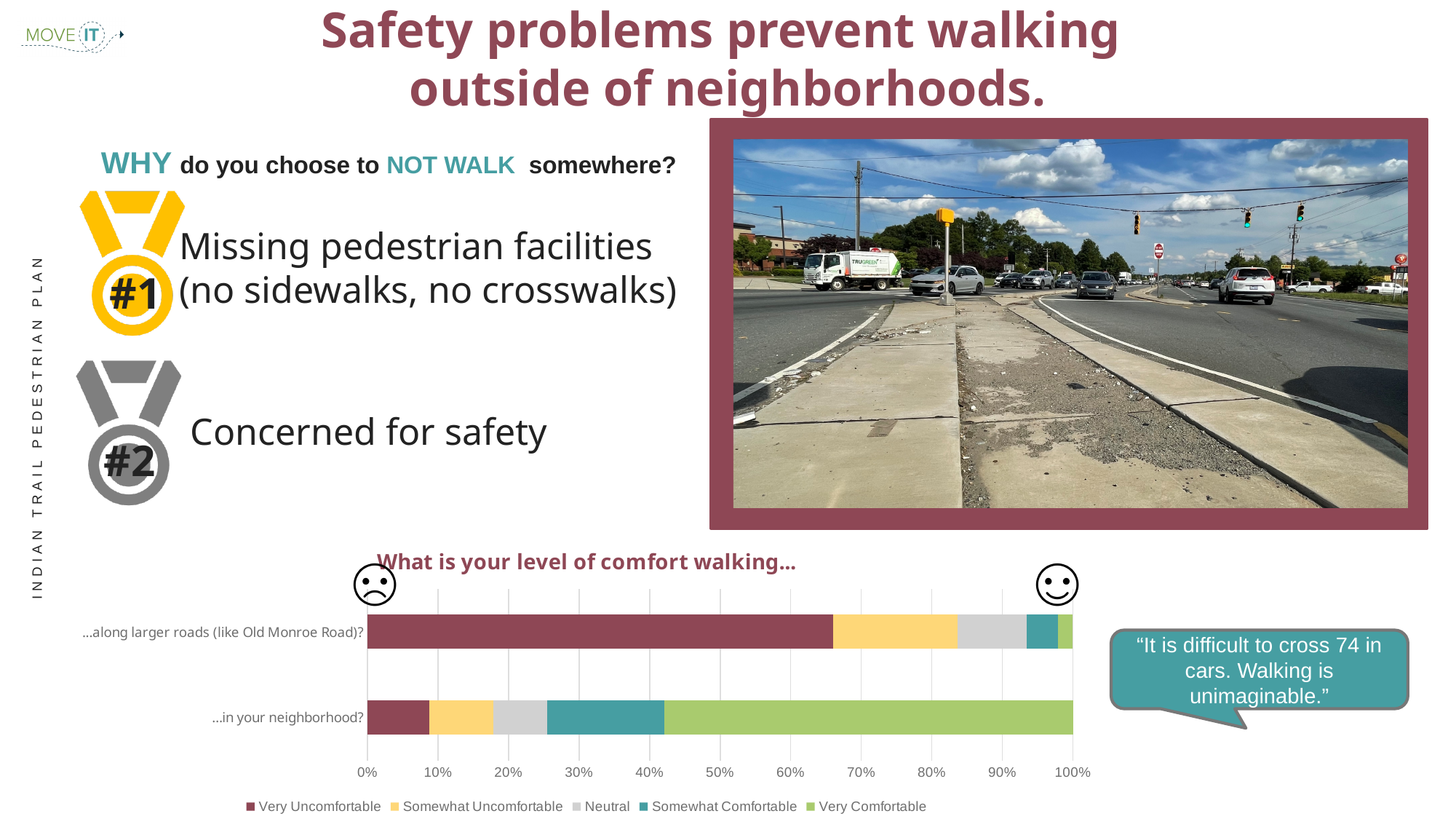
Is the 'Very Uncomfortable' share for '…in your neighborhood?' greater or less than 20%? less How many categories (rows) does the comfort-walking chart show? 2 What kind of chart is shown on the slide? Stacked bar chart Is the 'Very Uncomfortable' share for '…along larger roads (like Old Monroe Road)?' greater or less than 60%? greater What is the title of the chart? What is your level of comfort walking… Is the 'Very Comfortable' share for '…along larger roads (like Old Monroe Road)?' greater or less than 10%? less Which category has the larger 'Very Comfortable' share: '…along larger roads (like Old Monroe Road)?' or '…in your neighborhood?'? …in your neighborhood? Which category has the larger 'Very Uncomfortable' share: '…along larger roads (like Old Monroe Road)?' or '…in your neighborhood?'? …along larger roads (like Old Monroe Road)? How many series does the legend of the comfort-walking chart list? 5 Which legend entry is shown first in the chart's legend? Very Uncomfortable Which series makes up the largest share of the '…in your neighborhood?' bar? Very Comfortable